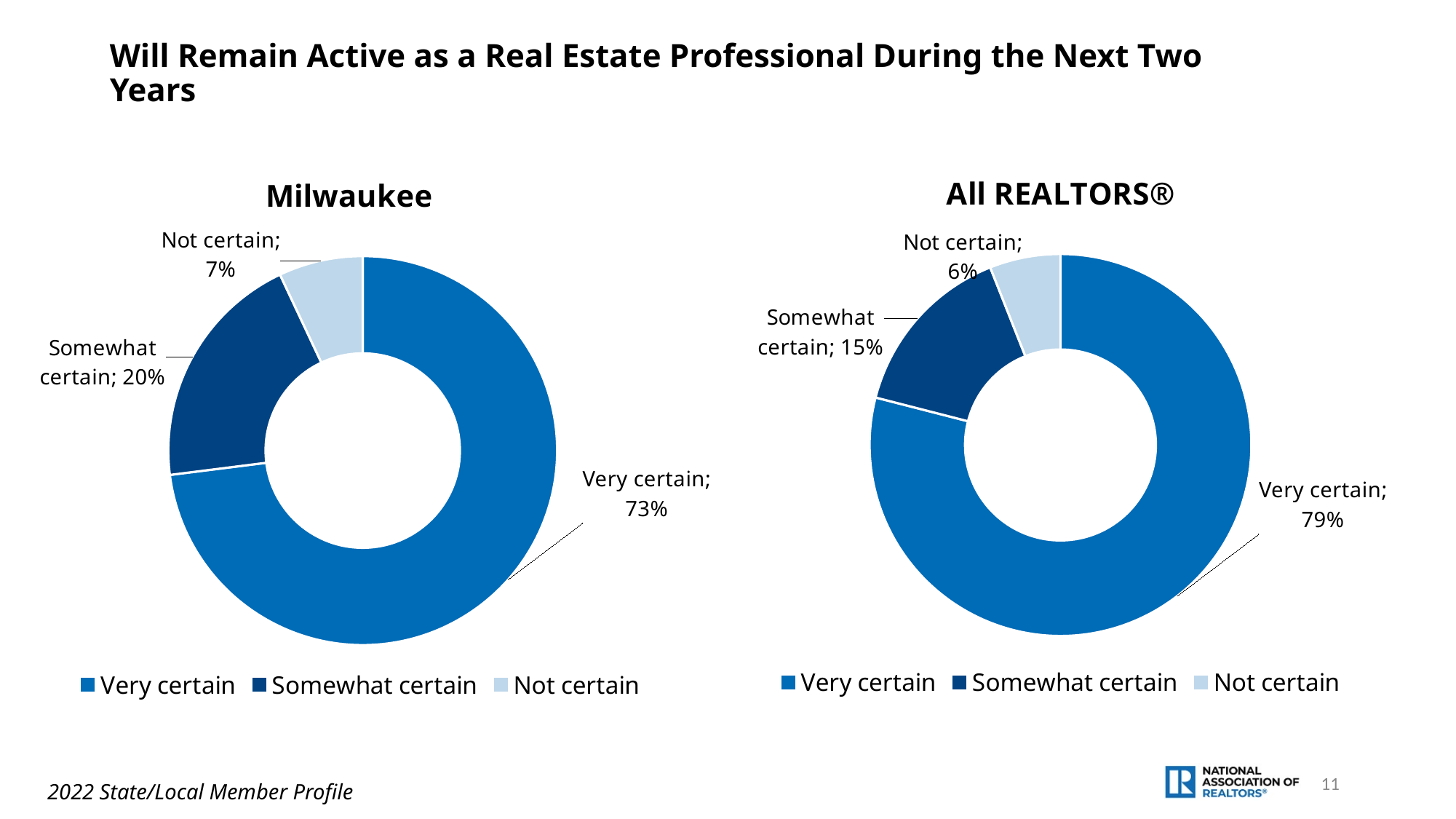
What is the difference between the Very certain share in the All REALTORS® chart and the Very certain share in the Milwaukee chart? 6 percentage points In the All REALTORS® chart, what share of respondents are Very certain? 79% In the Milwaukee chart, what share of respondents are Not certain? 7% In the Milwaukee chart, what share of respondents are Very certain? 73% Which is larger: the Somewhat certain share in the Milwaukee chart or in the All REALTORS® chart? Milwaukee What kind of chart is the All REALTORS® chart? Doughnut (pie) chart In the Milwaukee chart, which category has the largest share? Very certain How many categories does the Milwaukee chart show? 3 In the All REALTORS® chart, what share of respondents are Not certain? 6% In the All REALTORS® chart, what share of respondents are Somewhat certain? 15% In the All REALTORS® chart, which category has the smallest share? Not certain In the Milwaukee chart, what share of respondents are Somewhat certain? 20%